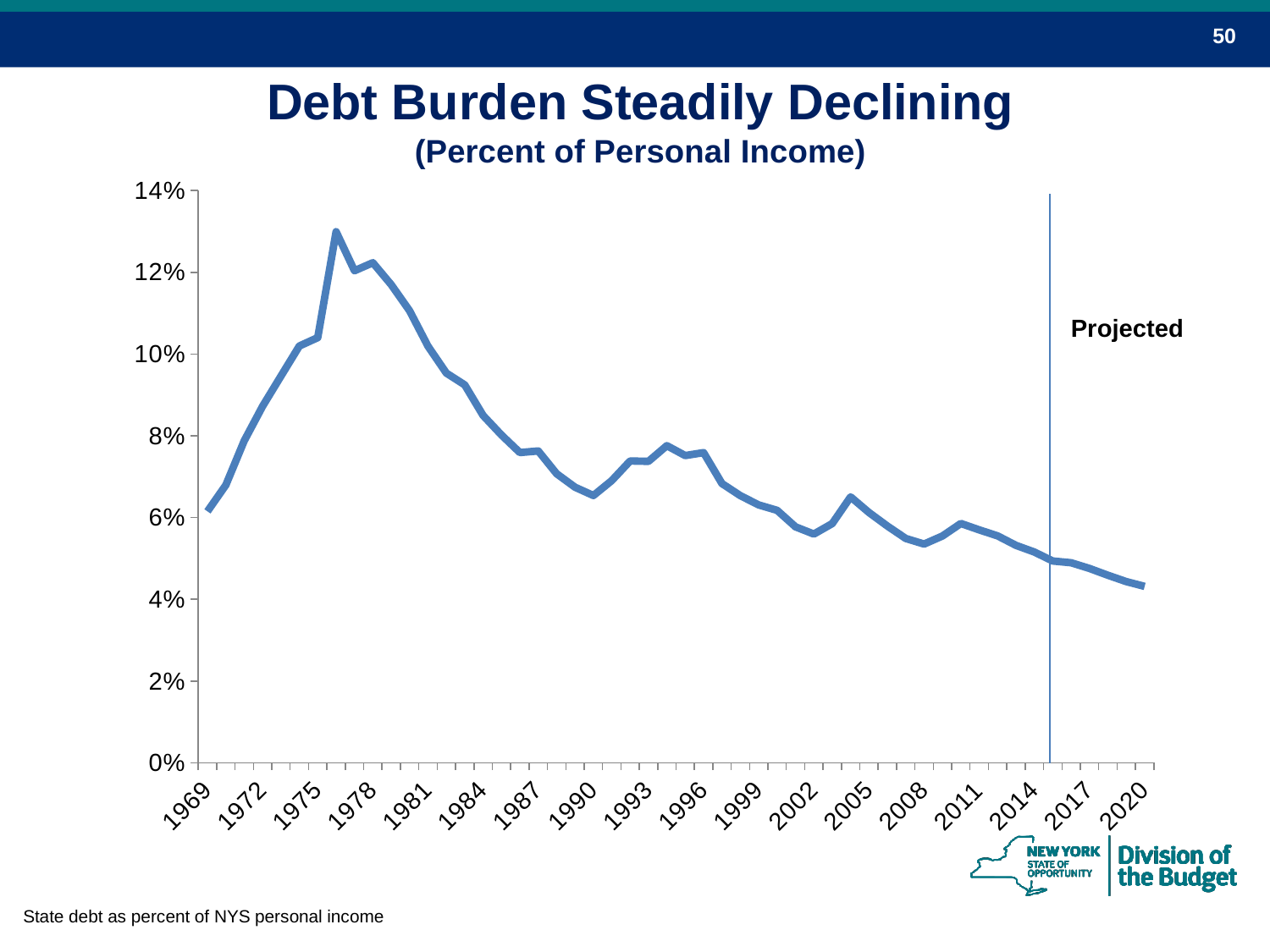
What kind of chart is shown on the slide? line chart Is the peak value of the line greater or less than 12%? greater Which year has the larger value, 1969 or 1978? 1978 Is the value for 1981 greater or less than 8%? greater Is the value for 1969 greater or less than 8%? less What is the title of the chart? Debt Burden Steadily Declining (Percent of Personal Income) What label appears to the right of the vertical line near 2015? Projected Overall, do the values rise or fall from 1978 to 2020? fall